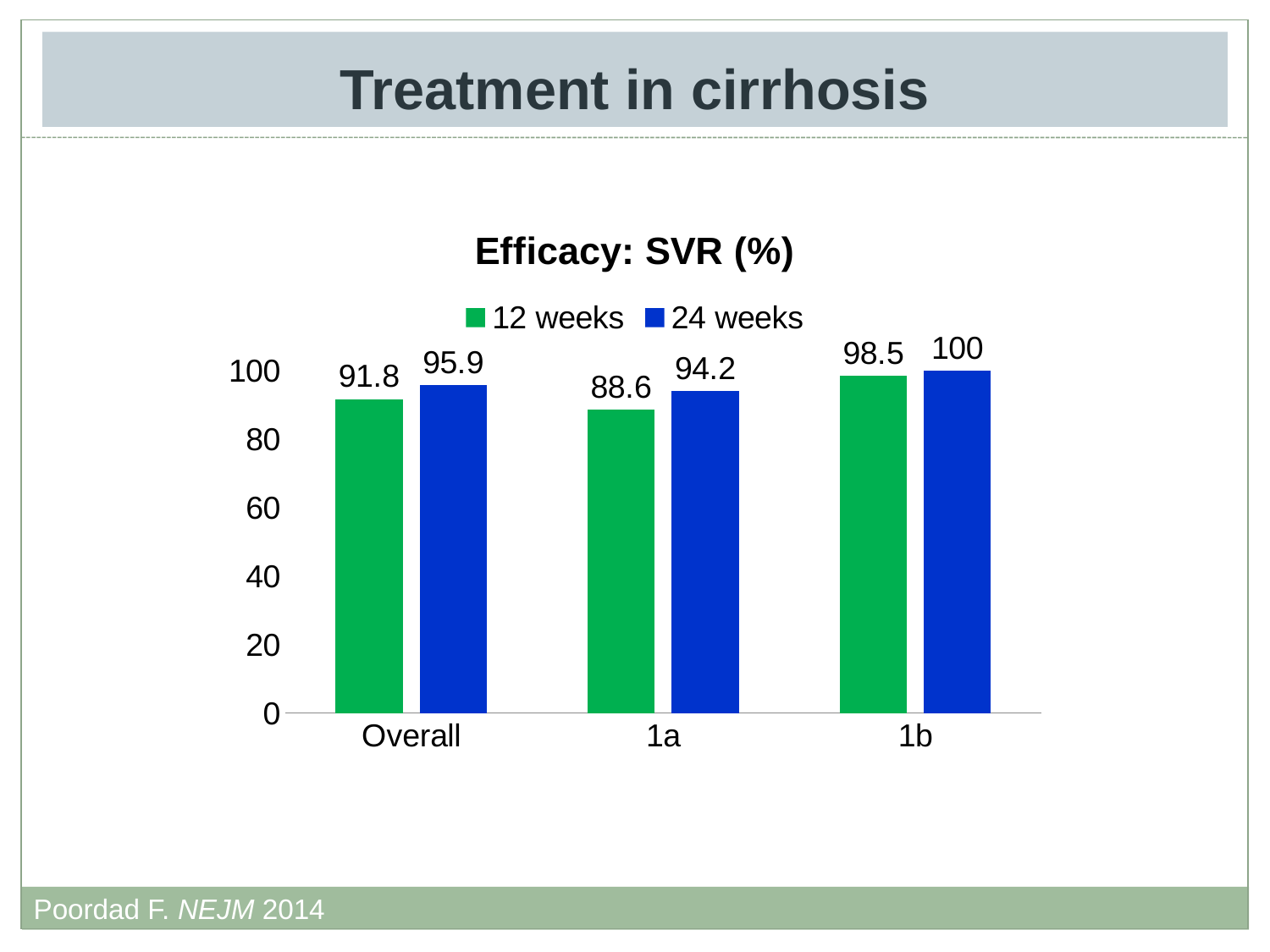
Which is larger in the Overall category: the 12 weeks value or the 24 weeks value? 24 weeks Which category has the lowest value for the 24 weeks series? 1a Which category has the highest value for the 12 weeks series? 1b What is the SVR value for the 24 weeks series in the 1a category? 94.2 How many series does the legend list? 2 Is the 12 weeks value for 1a greater or less than 80? greater How many categories are shown on the x axis? 3 What kind of chart is shown on the slide? Bar chart What is the SVR value for the 12 weeks series in the Overall category? 91.8 What is the difference between the 24 weeks and 12 weeks values in the 1a category? 5.6 What is the SVR value for the 24 weeks series in the 1b category? 100 What is the title of the chart? Efficacy: SVR (%)